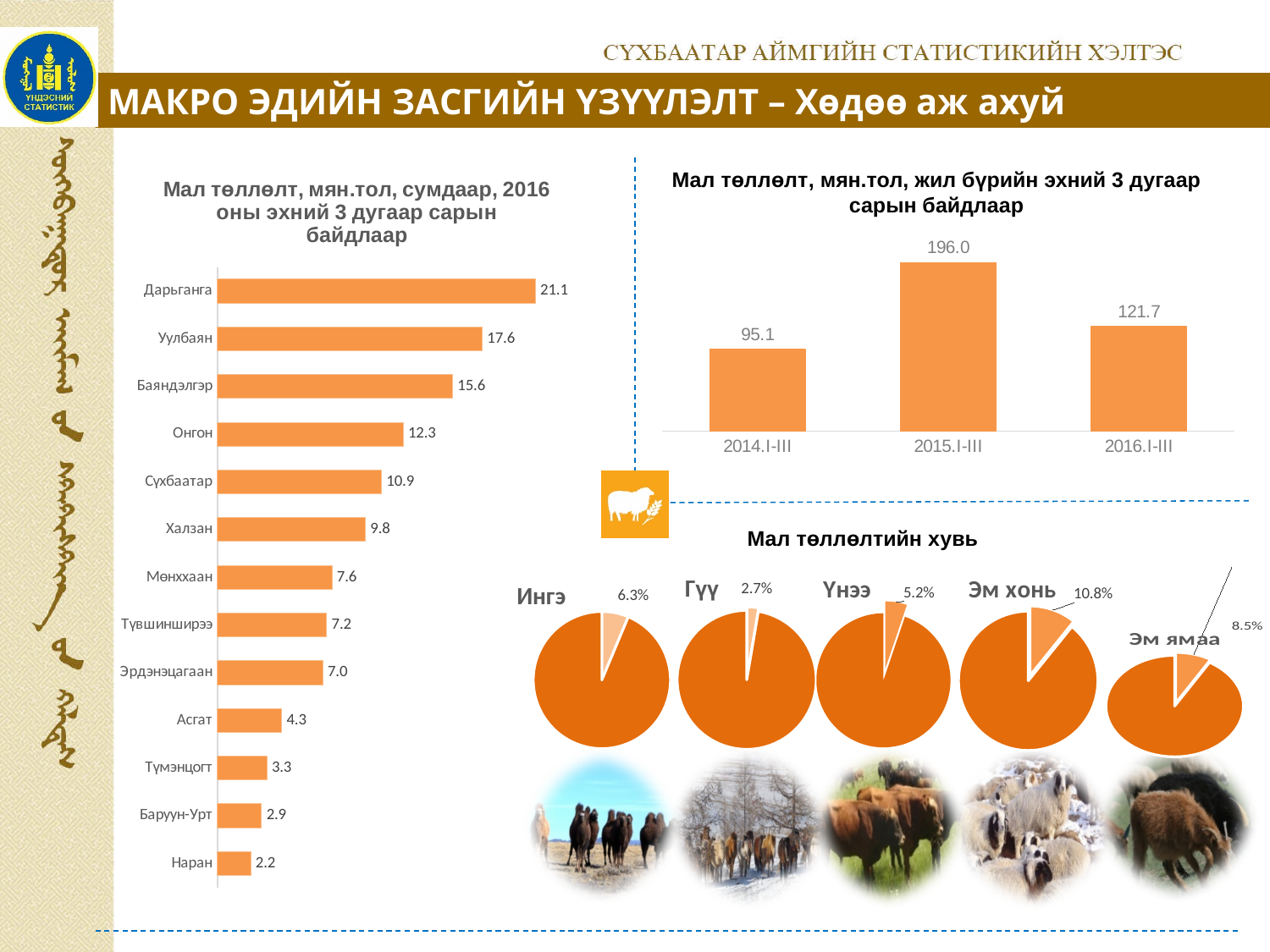
In the left chart (Мал төллөлт by сум, 2016), what is the value for Дарьганга? 21.1 In the left chart (Мал төллөлт by сум, 2016), which is larger, Онгон or Сүхбаатар? Онгон In the left chart (Мал төллөлт by сум, 2016), which сум has the lowest value? Наран In the top-right chart (Мал төллөлт by year, first 3 months), what is the value for 2015.I-III? 196.0 In the bottom-right pie charts (Мал төллөлтийн хувь), what share is shown for Эм хонь? 10.8% In the top-right chart (Мал төллөлт by year, first 3 months), which year has the highest value? 2015.I-III In the left chart (Мал төллөлт by сум, 2016), what is the difference between Уулбаян and Баяндэлгэр? 2.0 In the top-right chart (Мал төллөлт by year, first 3 months), what is the difference between 2016.I-III and 2014.I-III? 26.6 In the left chart (Мал төллөлт by сум, 2016), how many сум categories are shown? 13 In the left chart (Мал төллөлт by сум, 2016), what is the value for Баруун-Урт? 2.9 What type of chart is the top-right chart (Мал төллөлт by year, first 3 months)? Bar chart In the bottom-right pie charts (Мал төллөлтийн хувь), which animal has the smallest share? Гүү